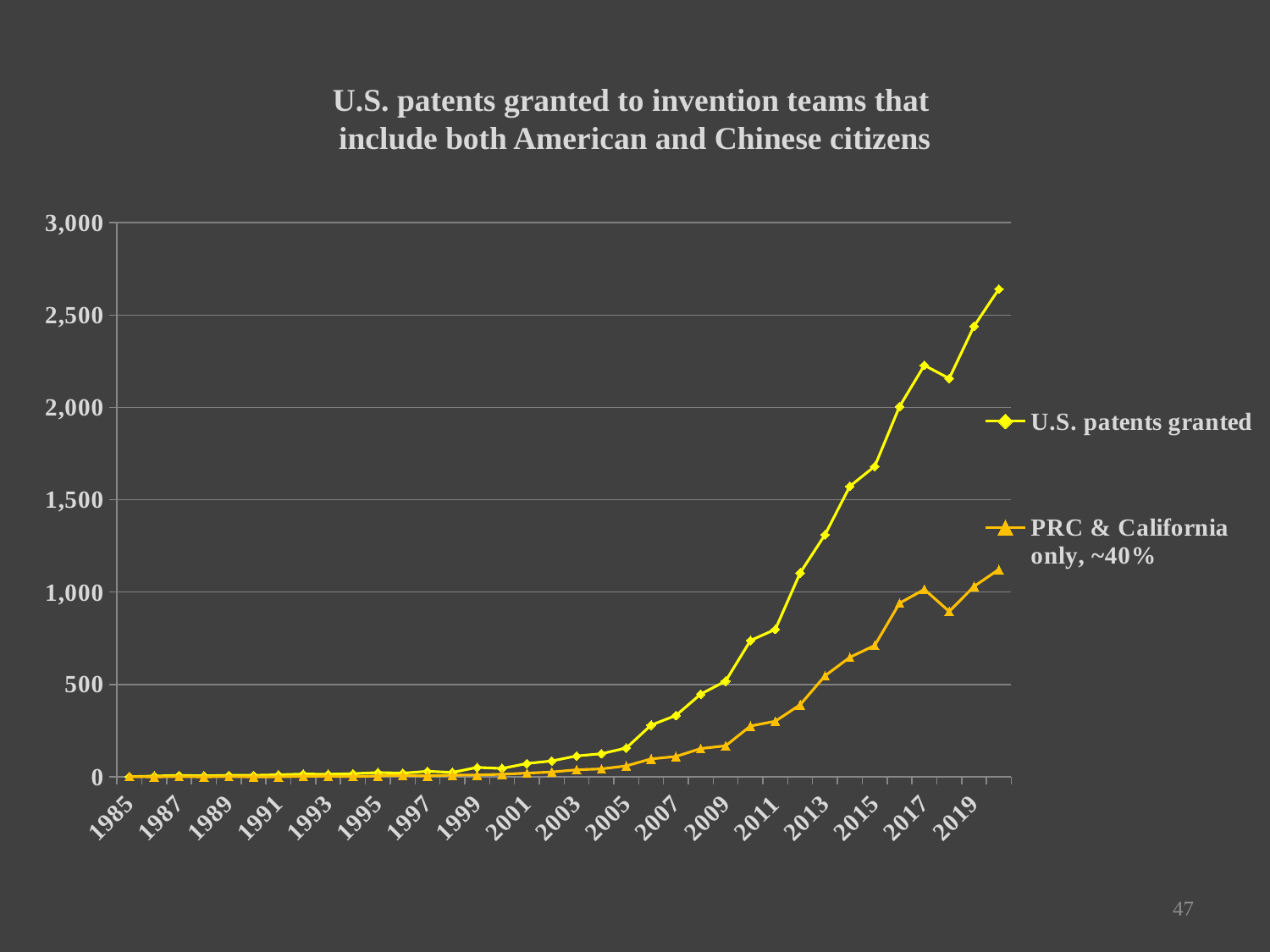
What is the title of the chart? U.S. patents granted to invention teams that include both American and Chinese citizens What kind of chart is shown on the slide? Line chart Is the value for PRC & California only in 2013 greater or less than 1,000? less Is the value for PRC & California only in 2015 greater or less than 500? greater In 2019, which series has the larger value: U.S. patents granted or PRC & California only? U.S. patents granted Overall, do the values for U.S. patents granted rise or fall from 1985 to the end of the period? Rise Is the value for U.S. patents granted in 2011 greater or less than 1,000? less Does the U.S. patents granted series reach its highest value at the start or at the end of the period shown? At the end How many series does the legend list? 2 What are the two series named in the legend? U.S. patents granted; PRC & California only, ~40%